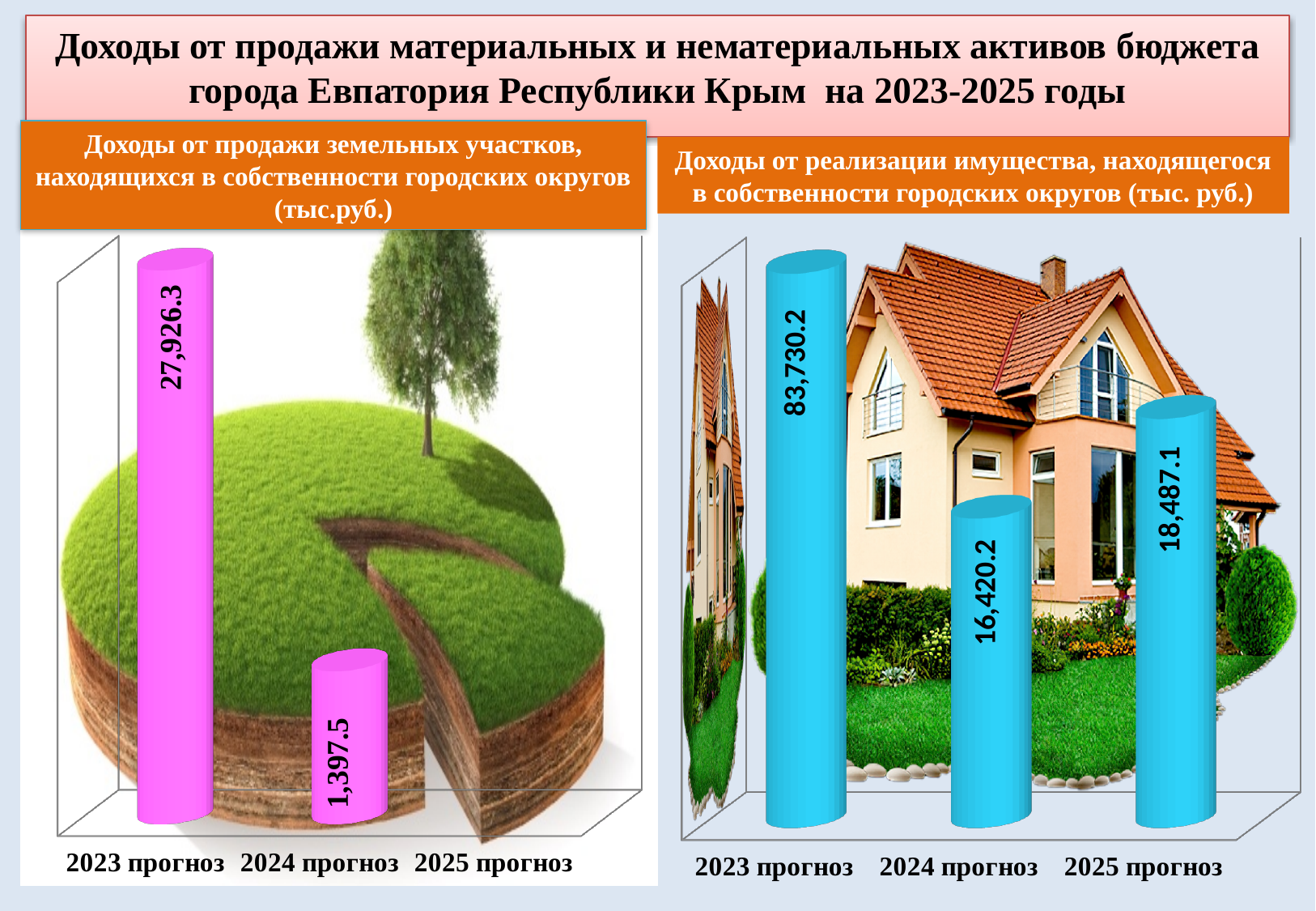
In the left chart (Доходы от продажи земельных участков), what is the value for 2023 прогноз? 27,926.3 In the right chart (Доходы от реализации имущества), what is the difference between the 2025 прогноз and 2024 прогноз values? 2,066.9 In the right chart (Доходы от реализации имущества), what is the value for 2024 прогноз? 16,420.2 In the left chart (Доходы от продажи земельных участков), what is the value for 2024 прогноз? 1,397.5 In the left chart (Доходы от продажи земельных участков), what is the difference between the 2023 прогноз and 2024 прогноз values? 26,528.8 In the right chart (Доходы от реализации имущества), which year has the highest value? 2023 прогноз In the right chart (Доходы от реализации имущества), which is larger: the value for 2024 прогноз or 2025 прогноз? 2025 прогноз In the right chart (Доходы от реализации имущества), what is the value for 2023 прогноз? 83,730.2 What kind of chart is the right chart (Доходы от реализации имущества)? bar chart In the right chart (Доходы от реализации имущества), which year has the lowest value? 2024 прогноз In the right chart (Доходы от реализации имущества), what is the total of the three plotted values? 118,637.5 In the right chart (Доходы от реализации имущества), what is the value for 2025 прогноз? 18,487.1